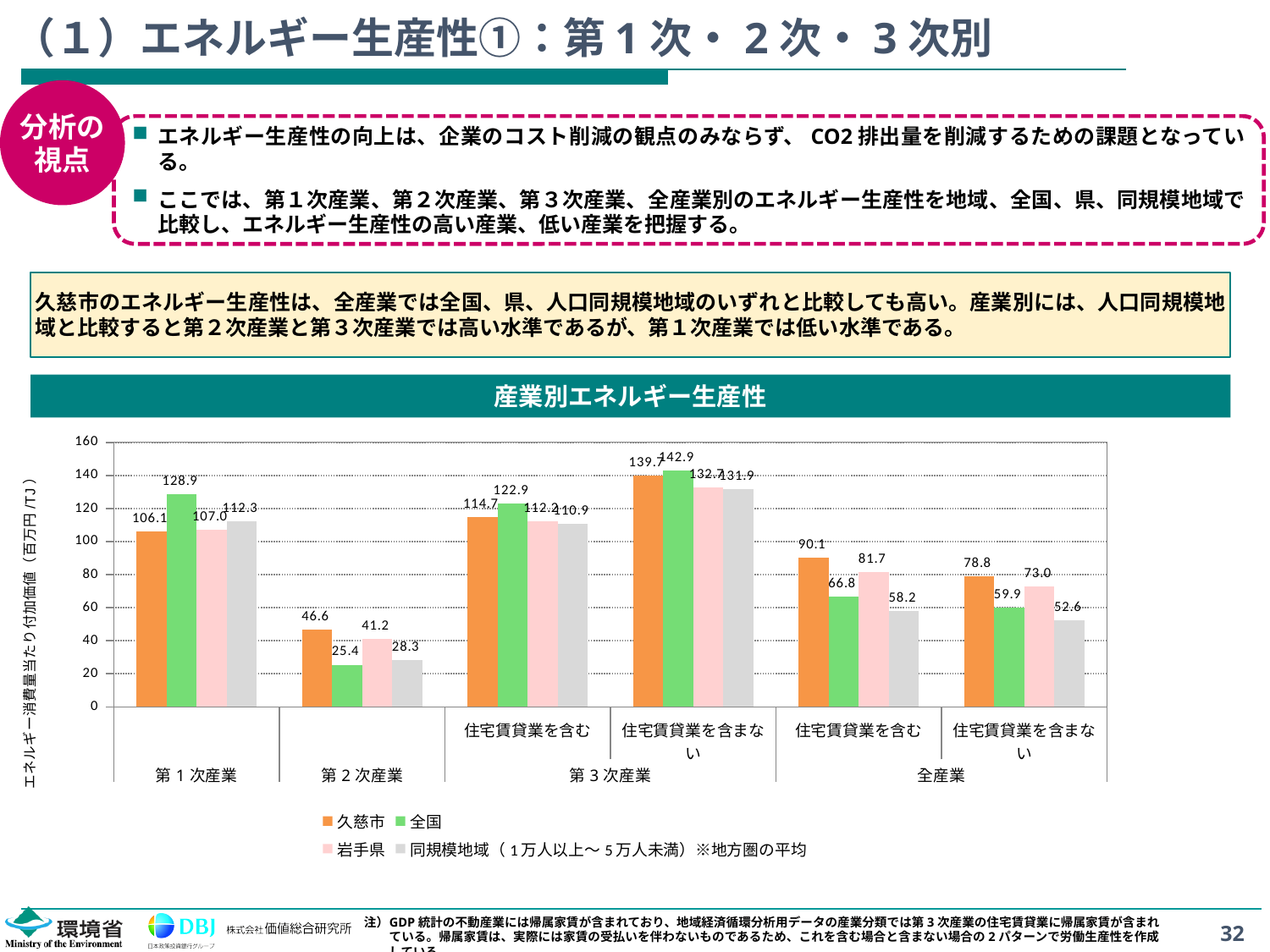
How many series does the legend of the 産業別エネルギー生産性 chart list? 4 In the 産業別エネルギー生産性 chart, which is larger in 第1次産業: the value for 久慈市 or the value for 岩手県? 岩手県 In the 産業別エネルギー生産性 chart, what is the difference between 久慈市 and 全国 in 全産業 (住宅賃貸業を含む)? 23.3 What kind of chart is shown under the title 産業別エネルギー生産性? bar chart What is the y-axis label of the 産業別エネルギー生産性 chart? エネルギー消費量当たり付加価値（百万円/TJ） In the 産業別エネルギー生産性 chart, what is the value for 岩手県 in 全産業 (住宅賃貸業を含む)? 81.7 In the 産業別エネルギー生産性 chart, what is the value for 久慈市 in 第2次産業? 46.6 In the 産業別エネルギー生産性 chart, is the value for 同規模地域 in 全産業 (住宅賃貸業を含まない) greater or less than 60? less In the 産業別エネルギー生産性 chart, what is the value for 全国 in 第1次産業? 128.9 In the 産業別エネルギー生産性 chart, which series has the highest value in 第2次産業? 久慈市 In the 産業別エネルギー生産性 chart, what is the difference between 久慈市 and 岩手県 in 第2次産業? 5.4 In the 産業別エネルギー生産性 chart, which series has the lowest value in 第2次産業? 全国